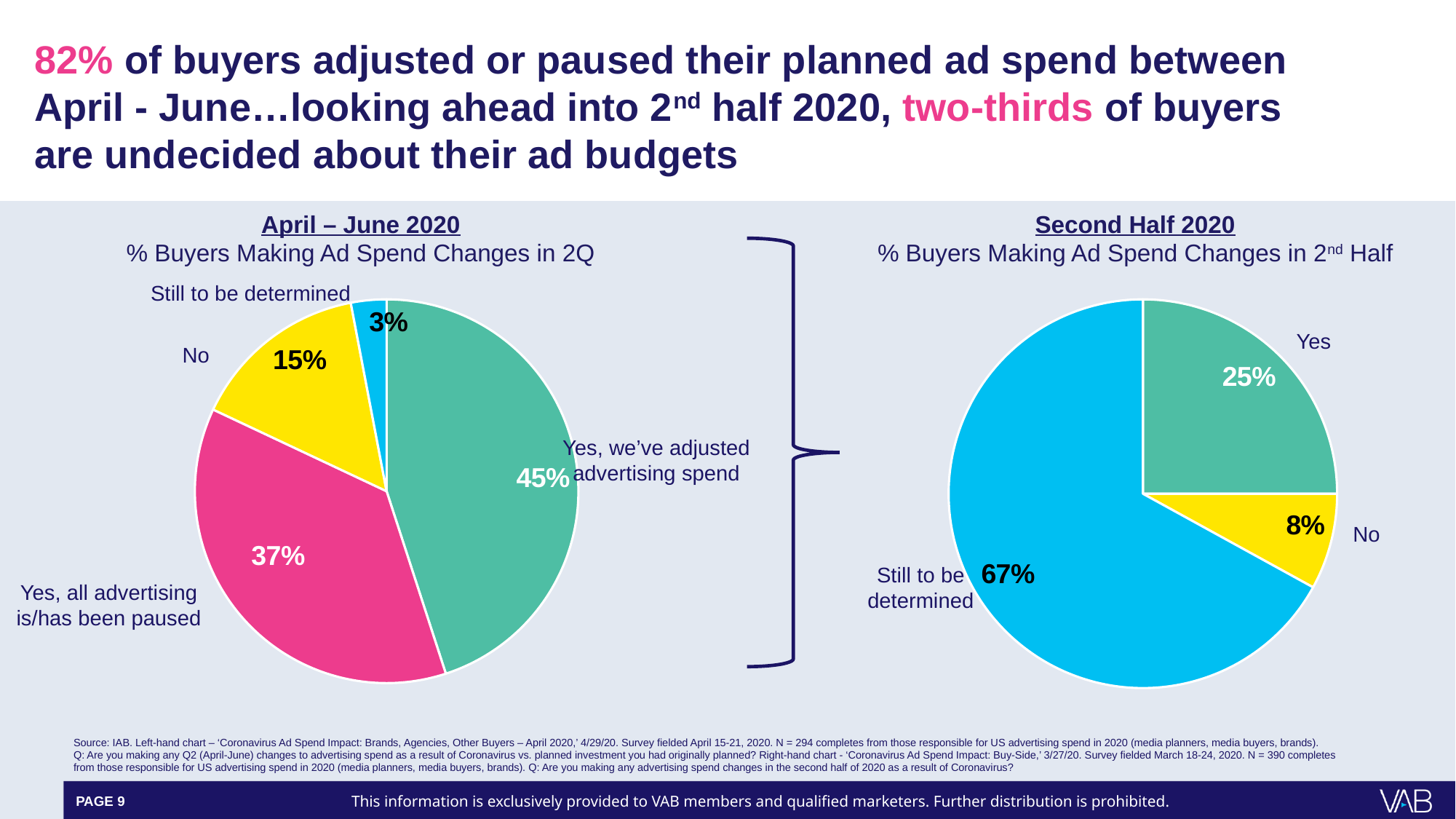
In the April – June 2020 chart, what percentage of buyers said 'Yes, we've adjusted advertising spend'? 45% What type of chart is used for the Second Half 2020 data? Pie chart How many slices does the April – June 2020 pie chart have? 4 Which is larger: the 'No' share in the April – June 2020 chart or the 'No' share in the Second Half 2020 chart? April – June 2020 In the Second Half 2020 chart, what is the difference between the 'Yes' share and the 'No' share? 17% In the Second Half 2020 chart, which category has the largest share? Still to be determined In the April – June 2020 chart, which category has the smallest share? Still to be determined In the Second Half 2020 chart, what percentage of buyers answered 'Yes'? 25% In the Second Half 2020 chart, what percentage of buyers said 'Still to be determined'? 67% In the April – June 2020 chart, what percentage of buyers answered 'No'? 15% In the April – June 2020 chart, what is the difference between the 'Yes, we've adjusted advertising spend' share and the 'No' share? 30% In the April – June 2020 chart, what percentage of buyers said 'Yes, all advertising is/has been paused'? 37%